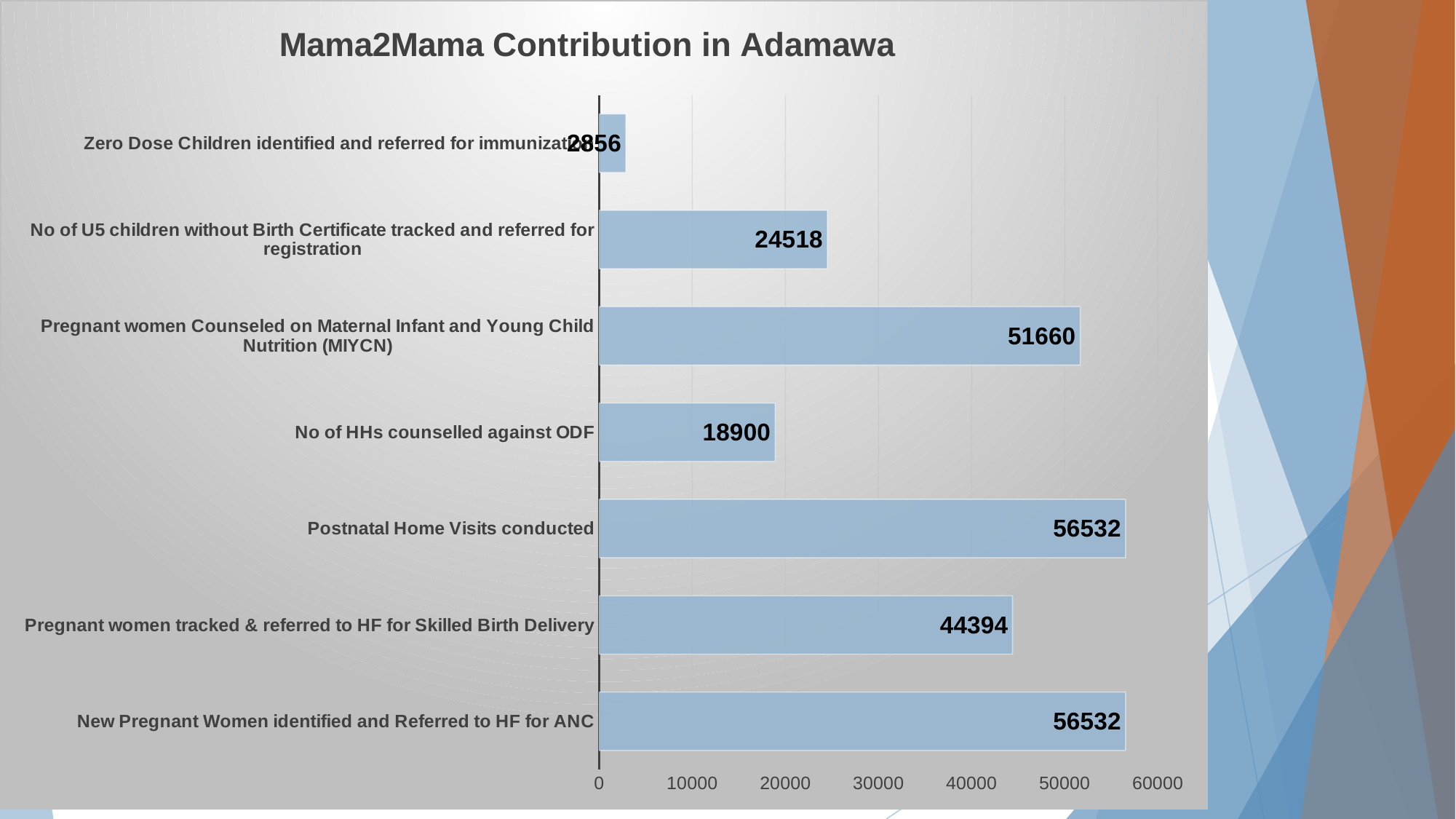
What is the difference between the value for Pregnant women Counseled on MIYCN and the value for Pregnant women tracked & referred to HF for Skilled Birth Delivery? 7266 What is the value for Pregnant women tracked & referred to HF for Skilled Birth Delivery? 44394 Which category has the lowest value? Zero Dose Children identified and referred for immunization What type of chart is shown on the slide? Bar chart What is the title of the chart? Mama2Mama Contribution in Adamawa What is the value for No of U5 children without Birth Certificate tracked and referred for registration? 24518 What is the value for Postnatal Home Visits conducted? 56532 Which is larger: Pregnant women Counseled on MIYCN or Pregnant women tracked & referred to HF for Skilled Birth Delivery? Pregnant women Counseled on MIYCN What is the difference between the value for No of U5 children without Birth Certificate tracked and referred for registration and the value for No of HHs counselled against ODF? 5618 Is the value for Pregnant women Counseled on MIYCN greater or less than 50000? greater How many categories are plotted in the chart? 7 What is the value for No of HHs counselled against ODF? 18900